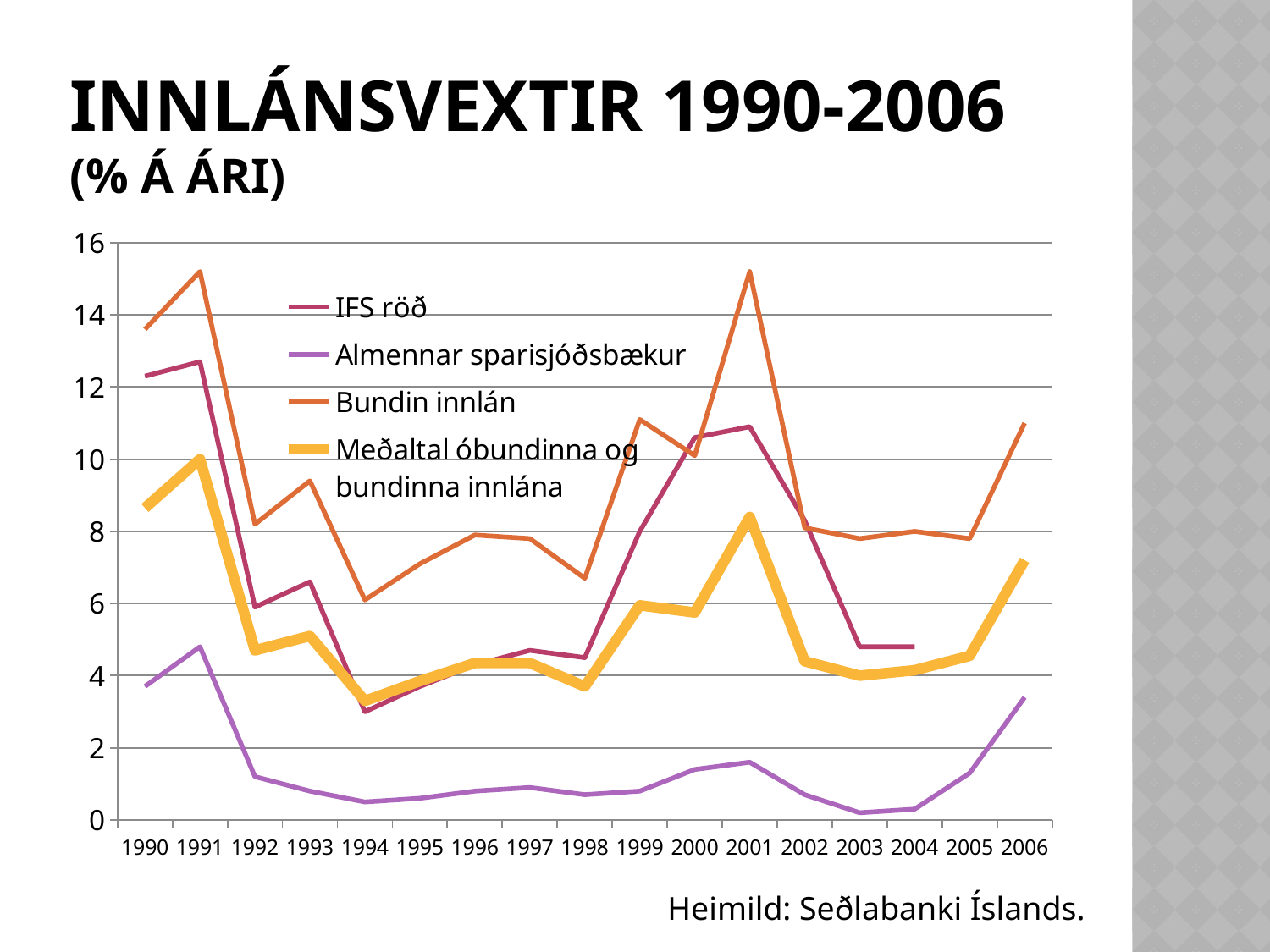
Is the value for IFS röð in 1994 greater or less than 4? less How many years are shown along the x axis? 17 In which year is IFS röð at its lowest? 1994 What kind of chart is shown on the slide? line chart In 2001, which is higher: Bundin innlán or IFS röð? Bundin innlán Is the value for Bundin innlán in 1991 greater or less than 14? greater Does Almennar sparisjóðsbækur rise or fall from 1991 to 1992? fall Is the value for Almennar sparisjóðsbækur in 2003 greater or less than 2? less In which year is Almennar sparisjóðsbækur at its highest? 1991 Which series is drawn with the thick yellow line? Meðaltal óbundinna og bundinna innlána How many series does the legend list? 4